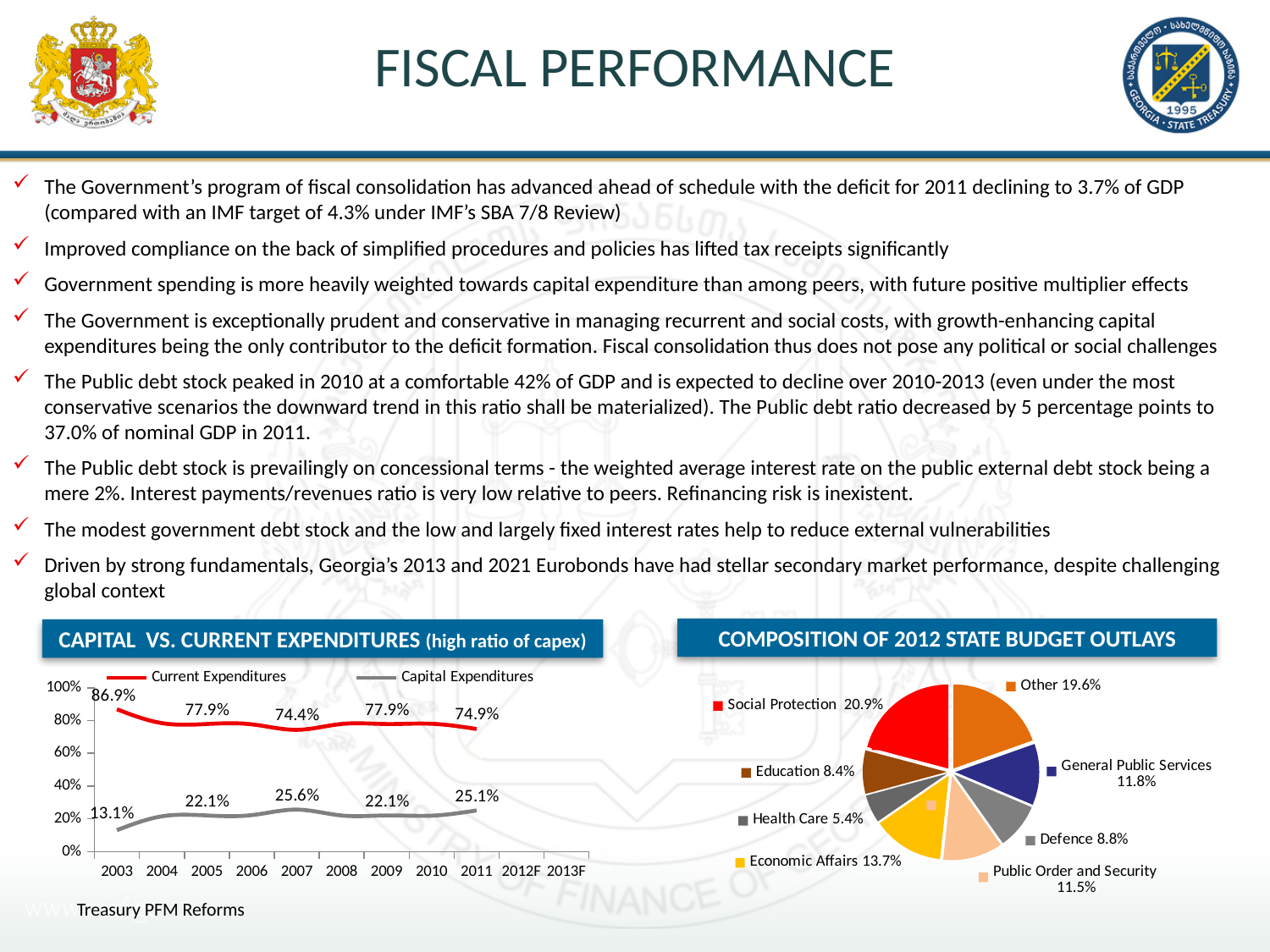
In the CAPITAL VS. CURRENT EXPENDITURES chart, what is the value for Capital Expenditures in 2003? 13.1% In the COMPOSITION OF 2012 STATE BUDGET OUTLAYS pie chart, what is the share for Economic Affairs? 13.7% In the COMPOSITION OF 2012 STATE BUDGET OUTLAYS pie chart, which is larger, Economic Affairs or Defence? Economic Affairs In the COMPOSITION OF 2012 STATE BUDGET OUTLAYS pie chart, how many slices are there? 8 In the COMPOSITION OF 2012 STATE BUDGET OUTLAYS pie chart, which category has the smallest share? Health Care What kind of chart is the CAPITAL VS. CURRENT EXPENDITURES chart? Line chart In the CAPITAL VS. CURRENT EXPENDITURES chart, how many series does the legend list? 2 In the CAPITAL VS. CURRENT EXPENDITURES chart, what is the value for Current Expenditures in 2003? 86.9% In the CAPITAL VS. CURRENT EXPENDITURES chart, what is the difference between Current Expenditures and Capital Expenditures in 2003? 73.8 percentage points In the COMPOSITION OF 2012 STATE BUDGET OUTLAYS pie chart, which category has the largest share? Social Protection In the CAPITAL VS. CURRENT EXPENDITURES chart, does the Current Expenditures line generally rise or fall from 2003 to 2011? Fall In the CAPITAL VS. CURRENT EXPENDITURES chart, how many years are shown on the x axis? 11